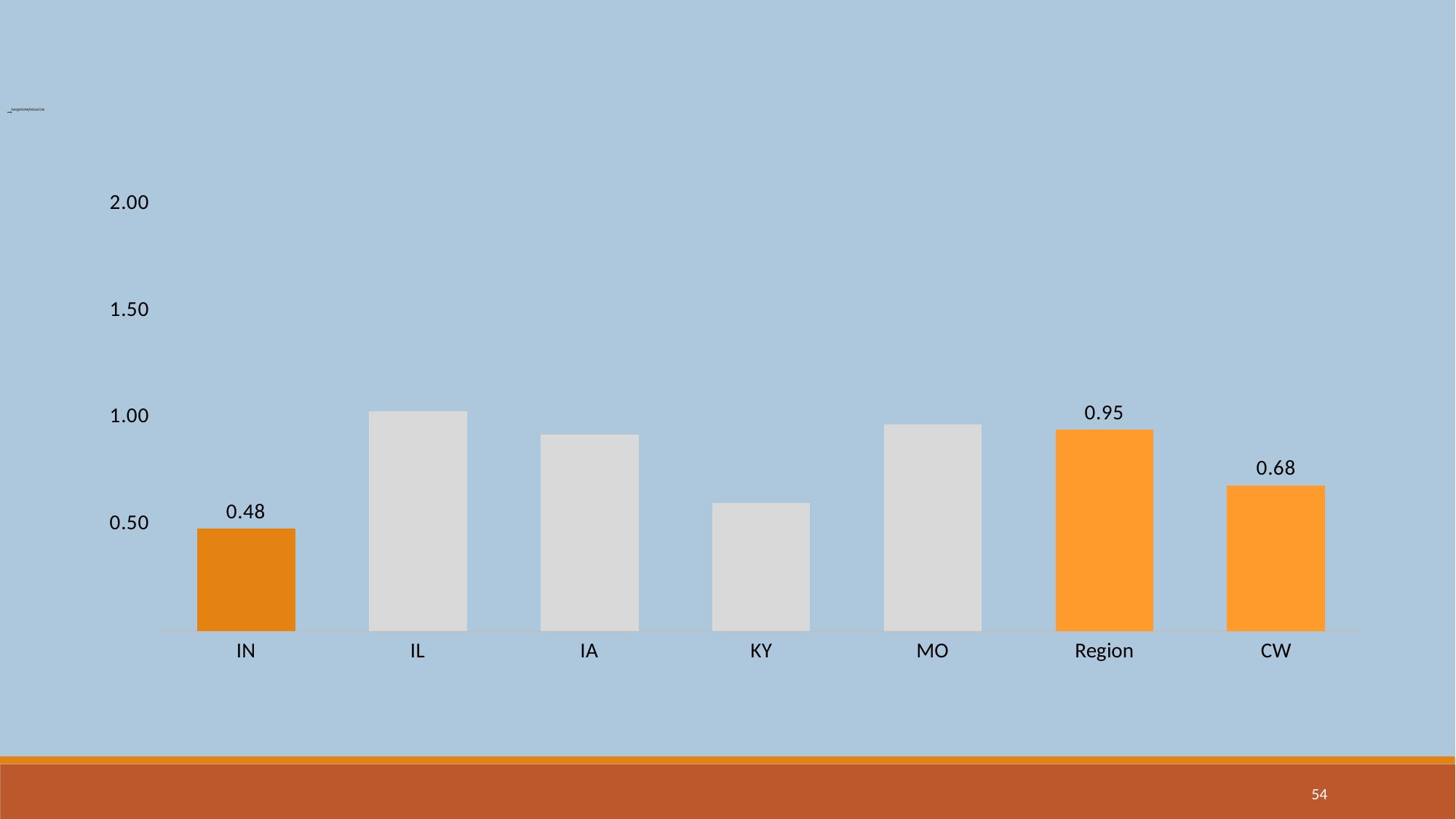
What is the value for IN? 0.48 Which category has the highest bar? IL What kind of chart is shown on the slide? bar chart What is the value for CW? 0.68 Is the value for KY greater or less than 0.50? greater What is the difference between the values for Region and CW? 0.27 Is the value for IA greater or less than 1.00? less Which is larger, the value for Region or the value for CW? Region Which category has the lowest bar? IN What is the value for Region? 0.95 How many categories are shown on the x axis? 7 What is the difference between the values for Region and IN? 0.47